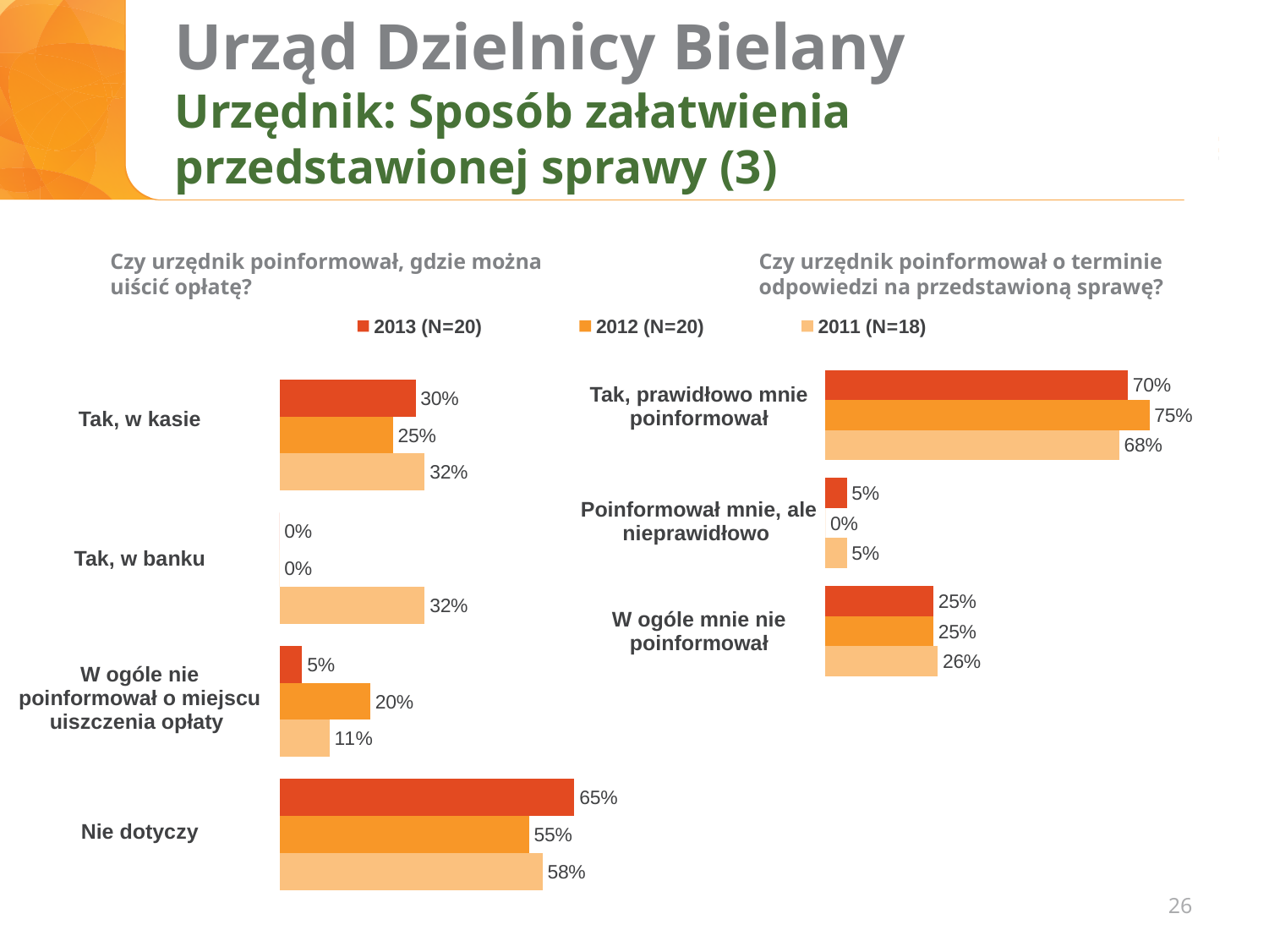
In the left chart ("Czy urzędnik poinformował, gdzie można uiścić opłatę?"), what is the value for "Nie dotyczy" in 2012 (N=20)? 55% In the left chart ("Czy urzędnik poinformował, gdzie można uiścić opłatę?"), how many categories are shown? 4 In the left chart ("Czy urzędnik poinformował, gdzie można uiścić opłatę?"), which is larger for "W ogóle nie poinformował o miejscu uiszczenia opłaty": the 2012 value or the 2011 value? 2012 In the right chart ("Czy urzędnik poinformował o terminie odpowiedzi na przedstawioną sprawę?"), which year has the lowest value for "Tak, prawidłowo mnie poinformował"? 2011 (N=18) How many series does the legend list? 3 In the left chart ("Czy urzędnik poinformował, gdzie można uiścić opłatę?"), what is the value for "Tak, w kasie" in 2013 (N=20)? 30% In the right chart ("Czy urzędnik poinformował o terminie odpowiedzi na przedstawioną sprawę?"), what is the value for "Tak, prawidłowo mnie poinformował" in 2012 (N=20)? 75% In the left chart ("Czy urzędnik poinformował, gdzie można uiścić opłatę?"), what is the value for "Tak, w banku" in 2011 (N=18)? 32% In the right chart ("Czy urzędnik poinformował o terminie odpowiedzi na przedstawioną sprawę?"), what is the difference between the 2013 and 2011 values for "Tak, prawidłowo mnie poinformował"? 2% In the left chart ("Czy urzędnik poinformował, gdzie można uiścić opłatę?"), what is the difference between the 2013 and 2012 values for "Nie dotyczy"? 10% In the left chart ("Czy urzędnik poinformował, gdzie można uiścić opłatę?"), which category has the highest value for 2013 (N=20)? Nie dotyczy In the right chart ("Czy urzędnik poinformował o terminie odpowiedzi na przedstawioną sprawę?"), what is the value for "W ogóle mnie nie poinformował" in 2011 (N=18)? 26%